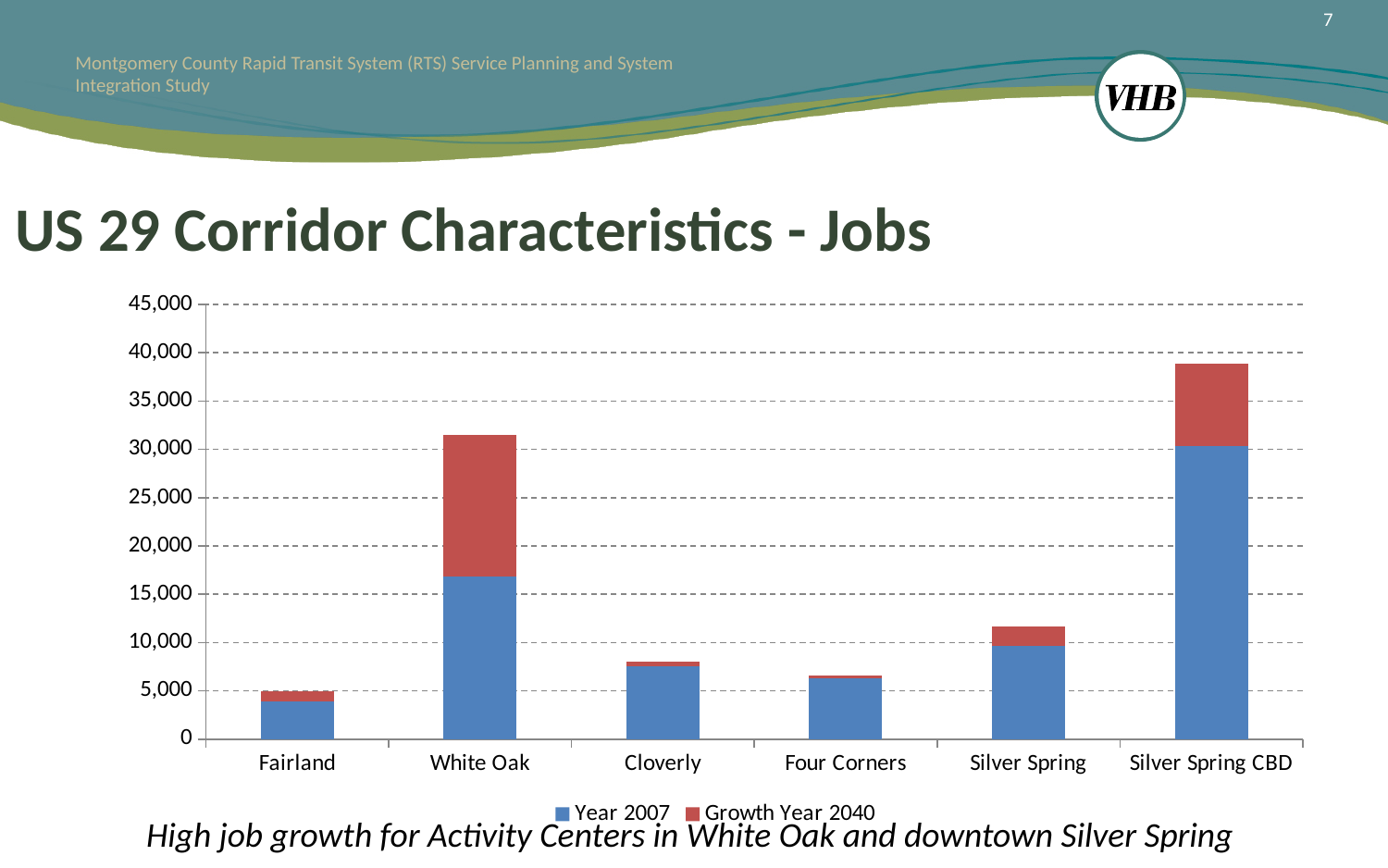
What kind of chart is shown on the slide? Stacked bar chart Which has the larger Year 2007 value, White Oak or Silver Spring CBD? Silver Spring CBD How many series does the legend list? 2 Which series is shown in red in the legend? Growth Year 2040 How many activity centers (categories) are shown on the x axis? 6 Is the total bar for Cloverly greater or less than 10,000? less Which activity center has the largest Growth Year 2040 segment? White Oak Is the total bar for Silver Spring CBD greater or less than 35,000? greater Which has the larger total bar, Silver Spring or Four Corners? Silver Spring Which activity center has the highest total bar? Silver Spring CBD Is the Year 2007 value for White Oak greater or less than 15,000? greater Which activity center has the lowest total bar? Fairland